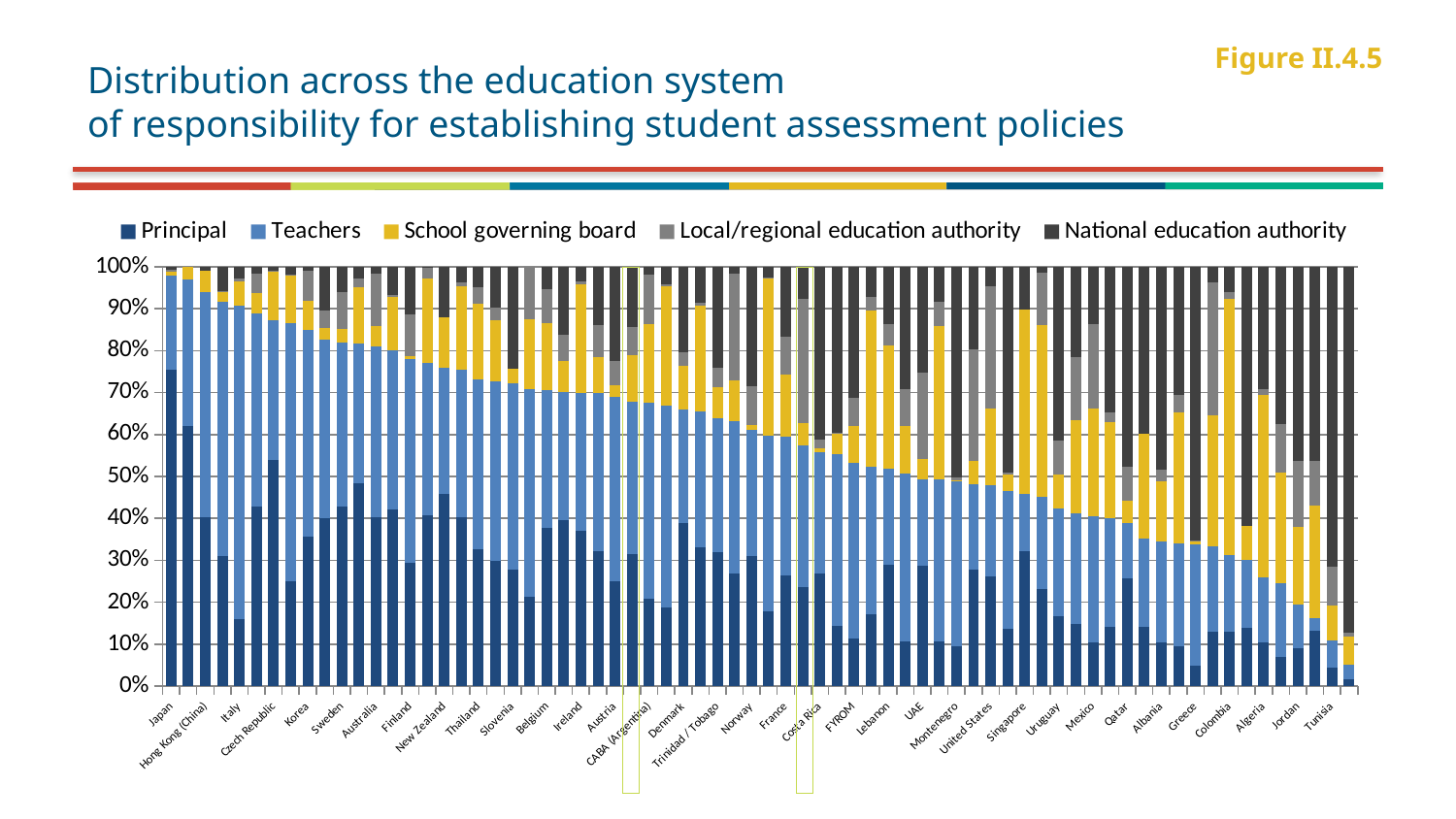
Does the National education authority share rise or fall moving from left to right across the countries? rise Is the Principal share for Japan greater or less than 70%? greater Is the combined Principal and Teachers share for Japan greater or less than 90%? greater Is the Principal share for Tunisia greater or less than 10%? less Which country is listed first on the left of the x axis? Japan Which country has the larger Principal share, Japan or Tunisia? Japan Which series is shown in yellow in the legend? School governing board What kind of chart is shown on the slide? Stacked bar chart Does the combined Principal and Teachers share rise or fall moving from left to right across the countries? fall What is the title of the chart on the slide? Distribution across the education system of responsibility for establishing student assessment policies How many series does the legend list? 5